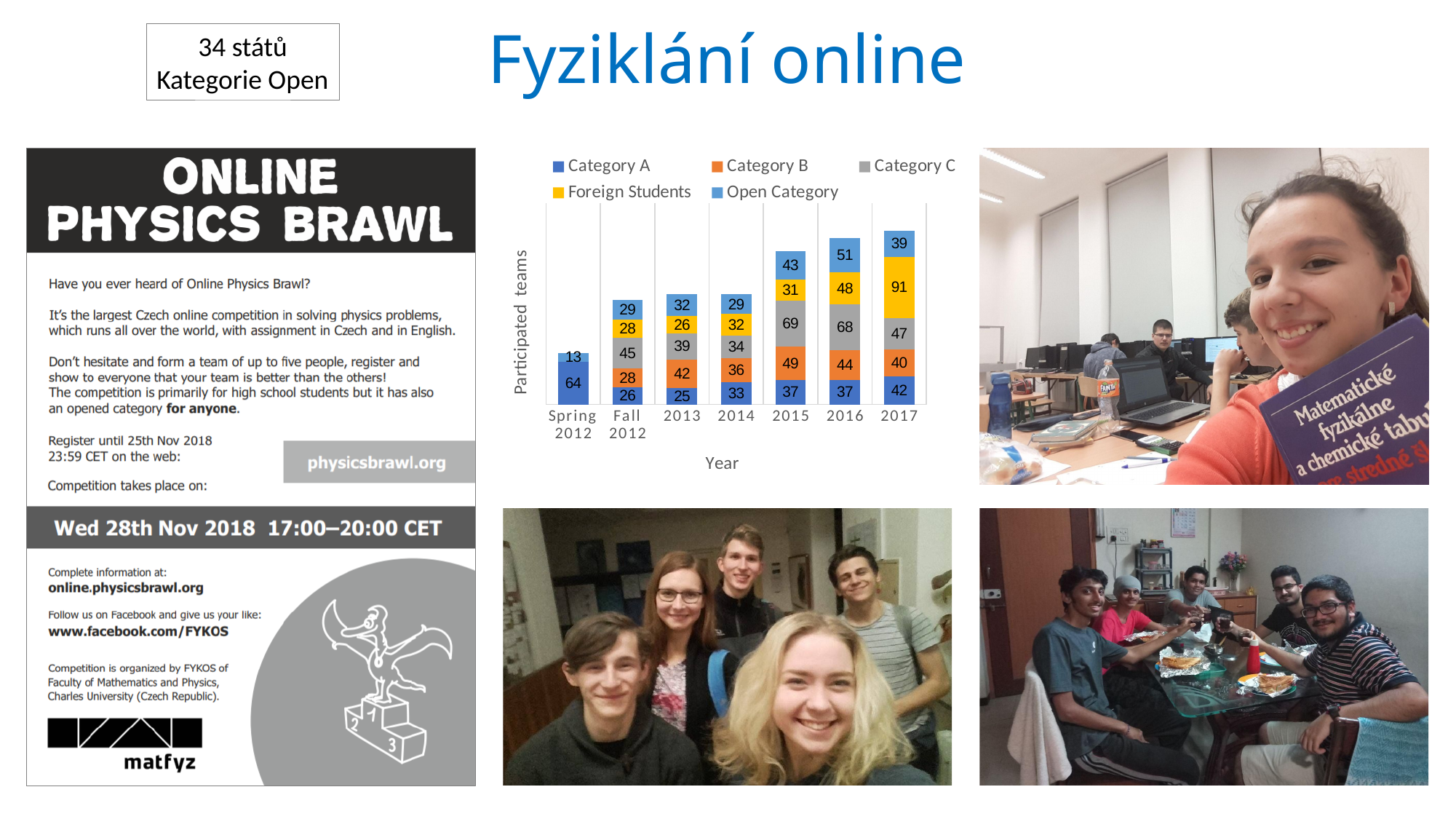
How many Category C teams participated in 2015? 69 How many year categories are shown on the x axis of the chart? 7 How many Category A teams participated in Spring 2012? 64 How many series does the chart legend list? 5 What is the label of the y axis of the chart? Participated teams What kind of chart is shown on the slide? stacked bar chart In which year was the Foreign Students value highest? 2017 How many Foreign Students teams participated in 2017? 91 In which year was the Category A value lowest? 2013 Which is larger: Category B in 2015 or Category B in 2016? Category B in 2015 What is the difference between the Open Category values for 2016 and 2017? 12 What is the total number of participated teams in 2016 across all categories? 248